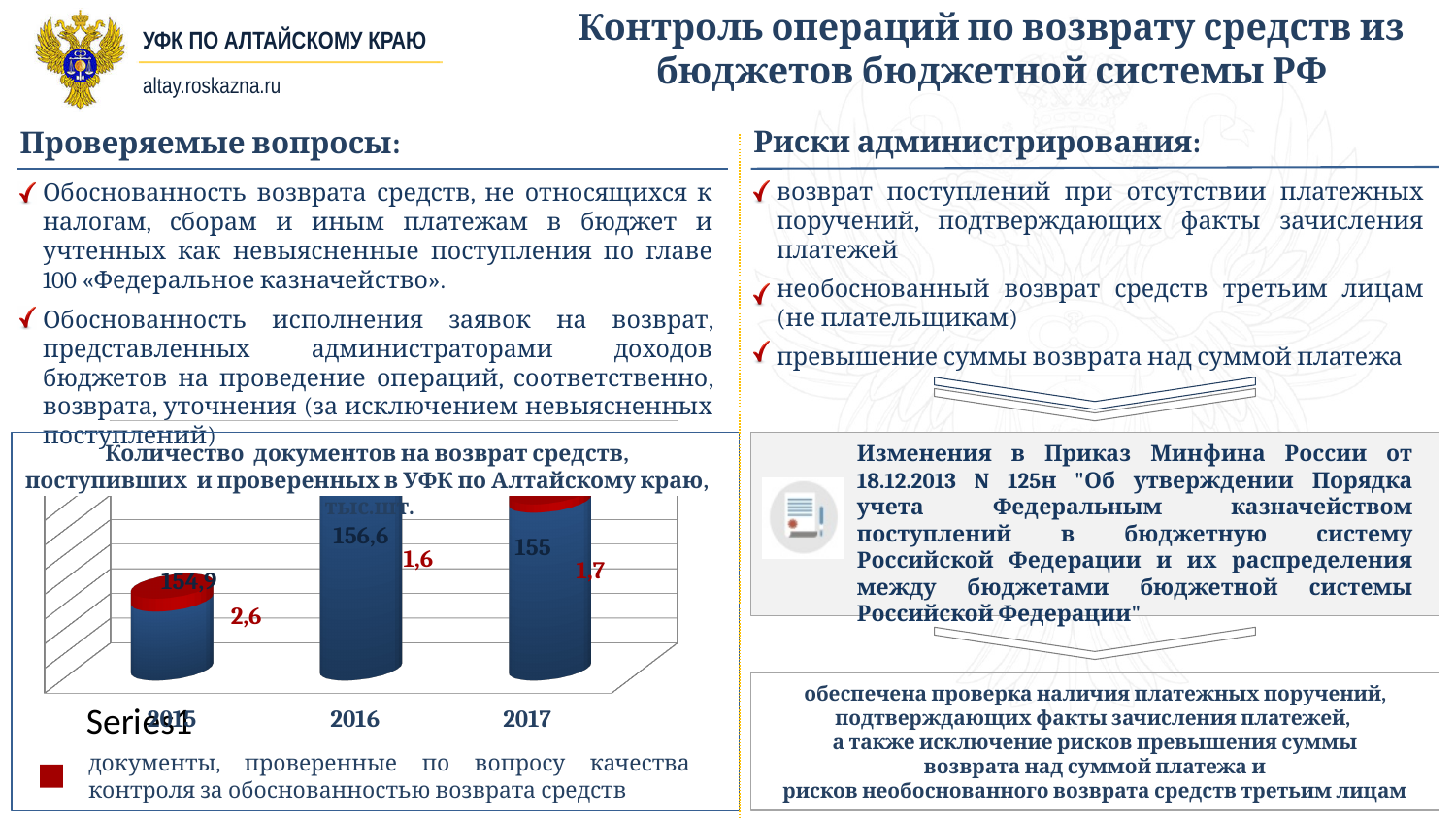
What is the value of the blue (Series1) segment for 2016? 156,6 What is the total of the stacked bar for 2015? 157,5 What is the value of the red segment for 2017? 1,7 Which year has the larger red segment value, 2015 or 2016? 2015 What kind of chart is shown on the slide? Bar chart What is the value of the blue (Series1) segment for 2017? 155 What is the difference between the blue (Series1) values for 2016 and 2015? 1,7 What is the value of the red segment (документы, проверенные по вопросу качества контроля) for 2015? 2,6 In which year is the red segment value the lowest? 2016 In which year is the blue (Series1) value the highest? 2016 How many years are shown on the x axis of the chart? 3